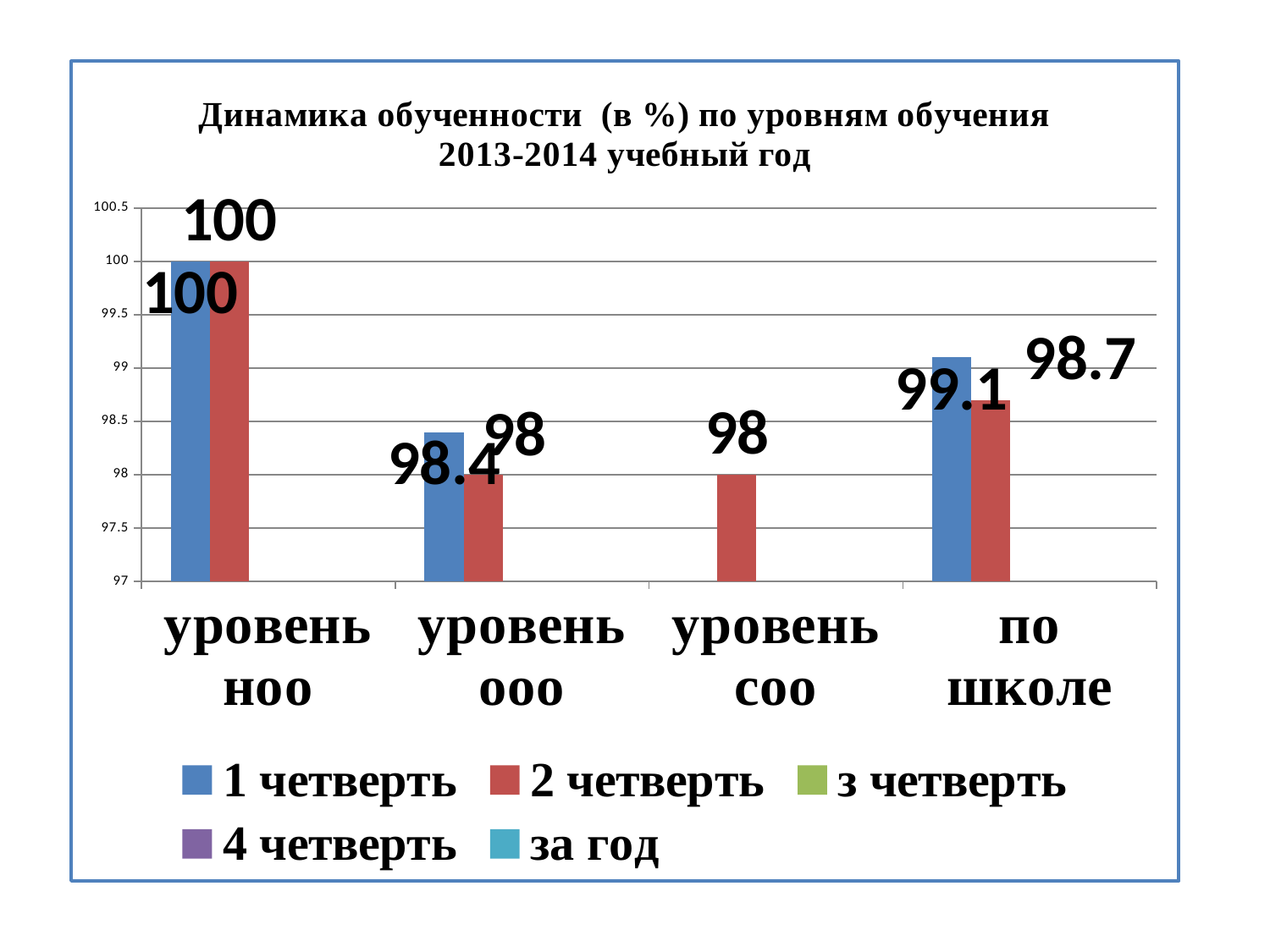
How many categories are shown on the x axis? 4 Which is larger at уровень ооо: the 1 четверть value or the 2 четверть value? 1 четверть What is the value for 1 четверть at по школе? 99.1 How many series does the legend list? 5 What is the value for 2 четверть at по школе? 98.7 What is the value for 1 четверть at уровень ооо? 98.4 Which category has the highest value for 2 четверть? уровень ноо What is the difference between the 1 четверть and 2 четверть values at по школе? 0.4 Is the value for 1 четверть at по школе greater or less than 99? greater What kind of chart is shown on the slide? bar chart What is the value for 2 четверть at уровень соо? 98 What is the value for 2 четверть at уровень ноо? 100